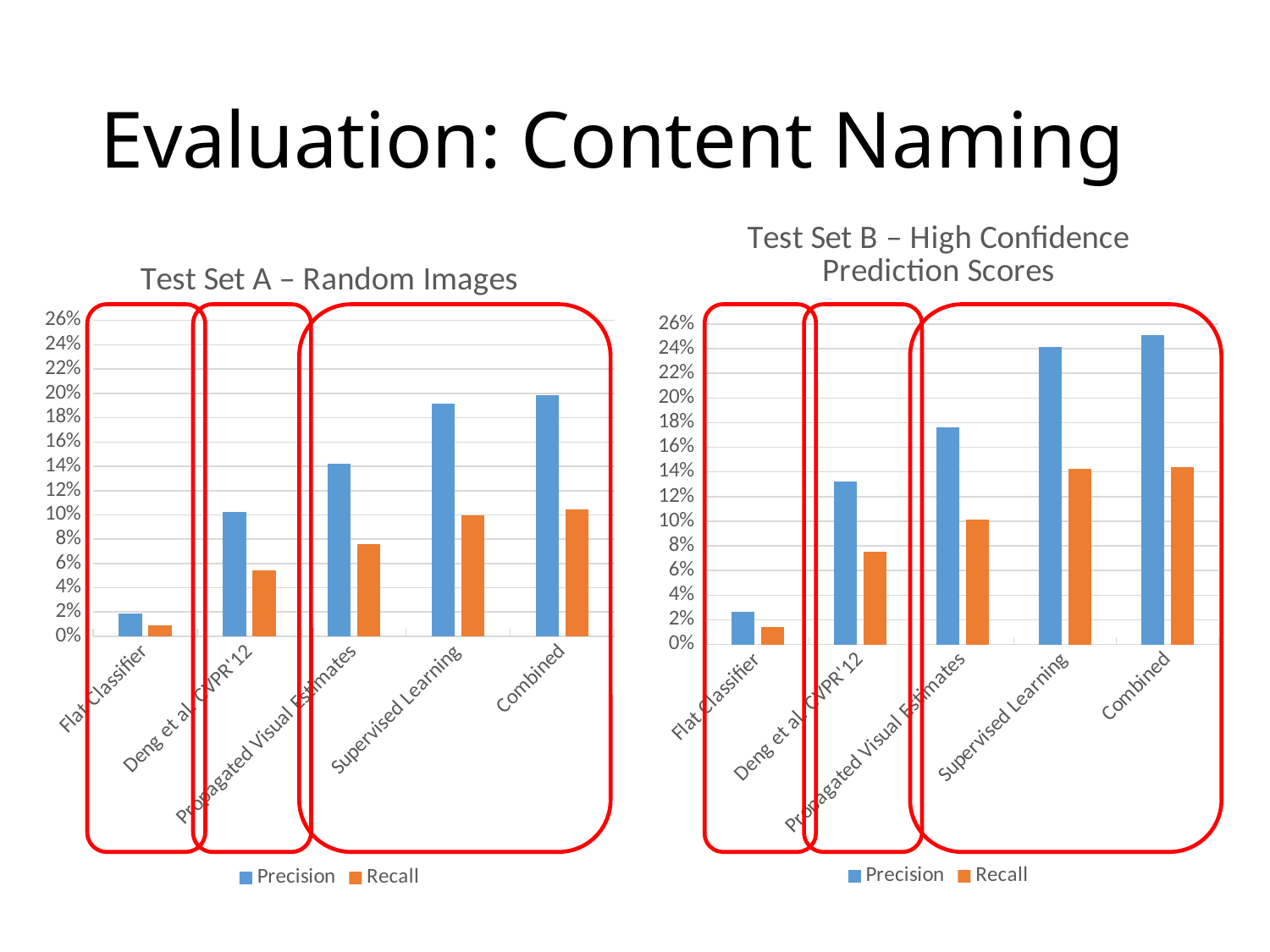
In the Test Set B – High Confidence Prediction Scores chart, do the Precision values generally rise or fall from Flat Classifier to Combined along the x axis? rise How many series does the legend of the Test Set B – High Confidence Prediction Scores chart list? 2 In the Test Set B – High Confidence Prediction Scores chart, which category has the lowest Recall? Flat Classifier In the Test Set A – Random Images chart, is the Precision for Supervised Learning greater or less than 18%? greater In the Test Set A – Random Images chart, is the Recall for Combined greater or less than 12%? less How many categories are shown on the x axis of the Test Set A – Random Images chart? 5 Which colour represents Recall in the legend of the Test Set A – Random Images chart? orange In the Test Set B – High Confidence Prediction Scores chart, is the Precision for Flat Classifier greater or less than 4%? less What type of chart is used for Test Set A – Random Images? bar chart In the Test Set A – Random Images chart, which is larger: the Precision for Deng et al. CVPR'12 or the Precision for Propagated Visual Estimates? Propagated Visual Estimates In the Test Set A – Random Images chart, which category has the lowest Precision? Flat Classifier